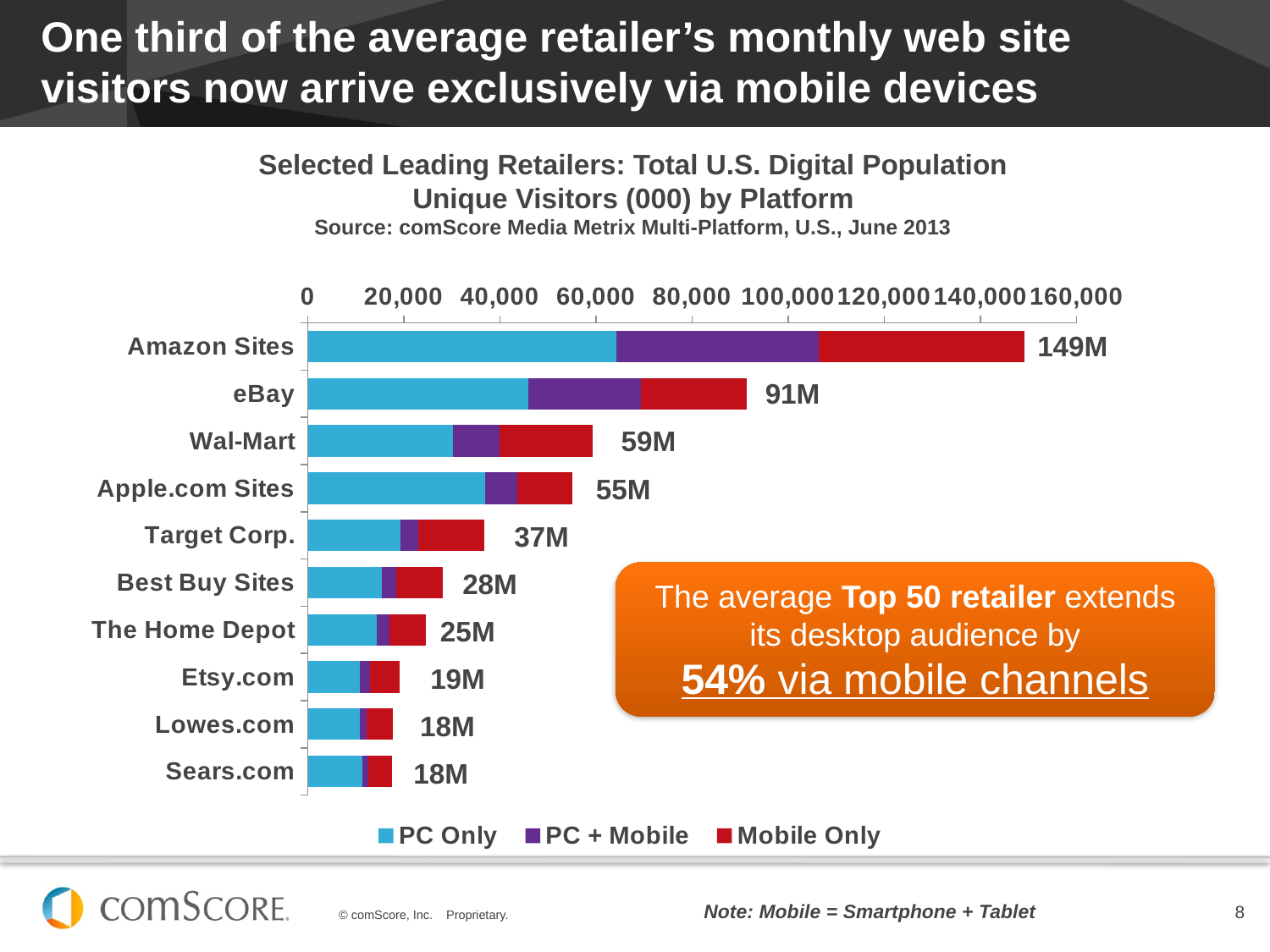
What is the total unique visitors label shown for eBay? 91M How many retailers are shown in the chart? 10 What kind of chart is shown on the slide? Stacked bar chart Which retailer has the highest total unique visitors? Amazon Sites What is the difference between the total labels for Amazon Sites and eBay? 58M What is the total unique visitors label shown for Amazon Sites? 149M What is the total unique visitors label shown for Target Corp.? 37M Is the PC Only segment for Amazon Sites greater or less than 40,000? greater Is the PC Only segment for Wal-Mart greater or less than 40,000? less How many series does the legend list? 3 What is the total unique visitors label shown for Etsy.com? 19M Which has a larger total, Wal-Mart or Apple.com Sites? Wal-Mart